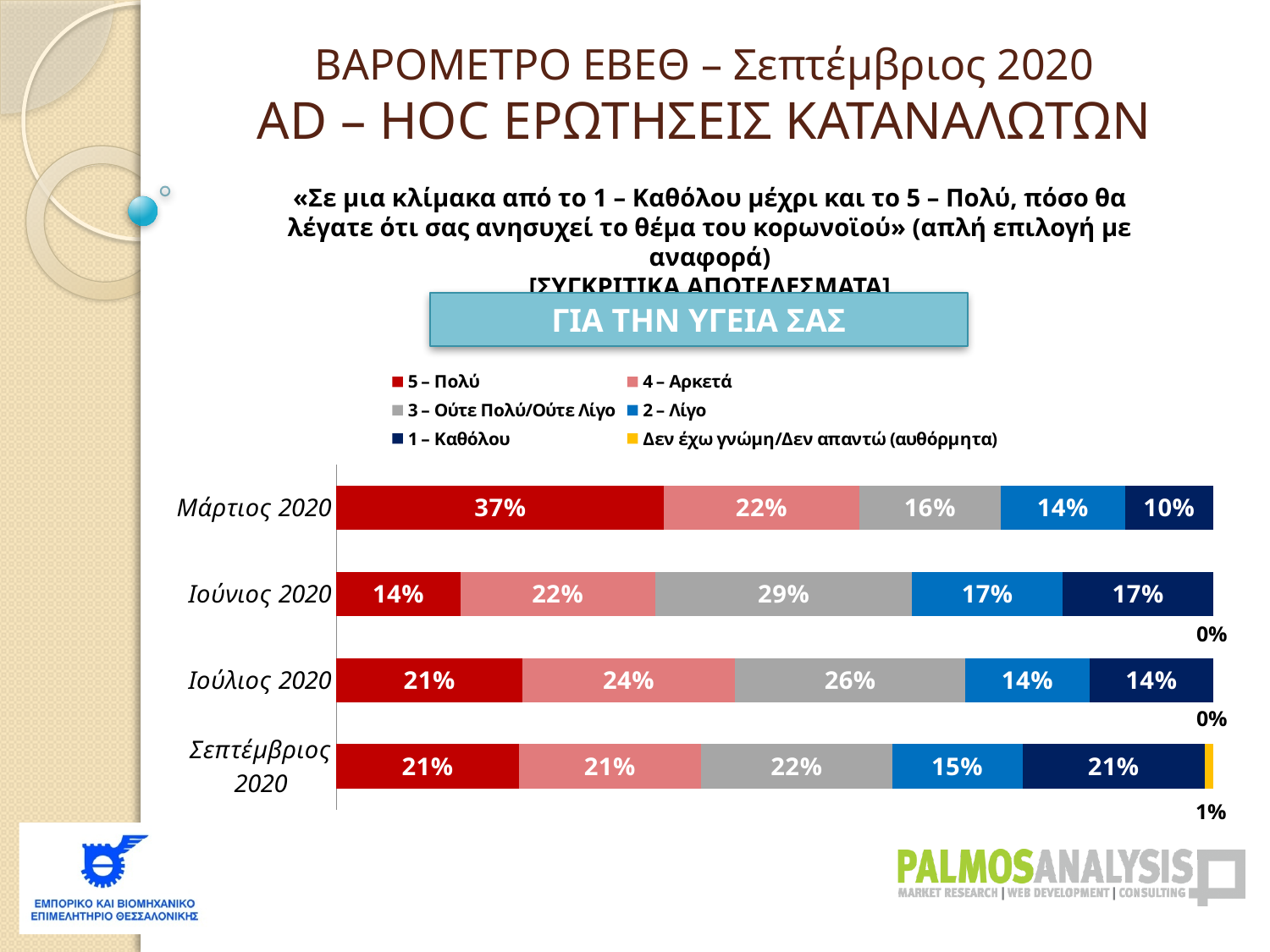
What is the value for "1 – Καθόλου" in Σεπτέμβριος 2020? 21% What is the value for "Δεν έχω γνώμη/Δεν απαντώ (αυθόρμητα)" in Σεπτέμβριος 2020? 1% What type of chart is shown on the slide? Stacked bar chart What is the value for "3 – Ούτε Πολύ/Ούτε Λίγο" in Ιούνιος 2020? 29% What is the difference between the "5 – Πολύ" values for Μάρτιος 2020 and Ιούνιος 2020? 23 percentage points How many series does the legend list? 6 Which period has the highest value for "5 – Πολύ"? Μάρτιος 2020 What is the value for "2 – Λίγο" in Ιούλιος 2020? 14% How many periods (bars) are shown in the chart? 4 Which period has the larger value for "3 – Ούτε Πολύ/Ούτε Λίγο": Ιούνιος 2020 or Ιούλιος 2020? Ιούνιος 2020 Which period has the lowest value for "5 – Πολύ"? Ιούνιος 2020 What percentage of respondents answered "5 – Πολύ" in Μάρτιος 2020? 37%